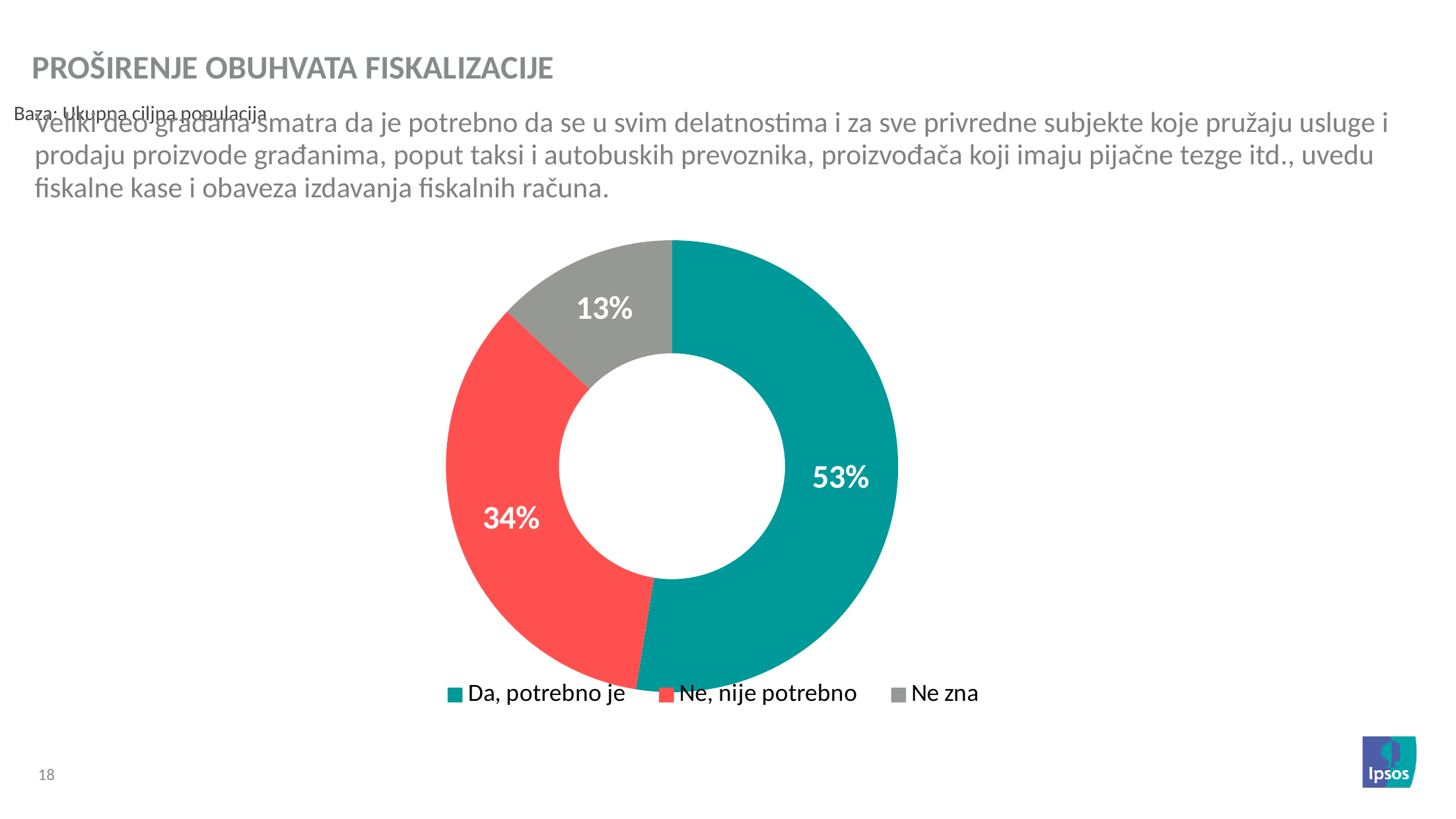
What share of respondents answered "Da, potrebno je"? 53% What is the title of the slide? PROŠIRENJE OBUHVATA FISKALIZACIJE What share of respondents answered "Ne, nije potrebno"? 34% How many categories does the chart show? 3 Which category has the smallest share of the pie? Ne zna Which is larger: the share for "Ne, nije potrebno" or the share for "Ne zna"? Ne, nije potrebno What is the difference in percentage points between "Ne, nije potrebno" and "Ne zna"? 21 percentage points What colour is the "Ne, nije potrebno" slice? Red What share of respondents answered "Ne zna"? 13% What kind of chart is shown on the slide? Pie chart (doughnut) Which category has the largest share of the pie? Da, potrebno je What is the difference in percentage points between "Da, potrebno je" and "Ne, nije potrebno"? 19 percentage points